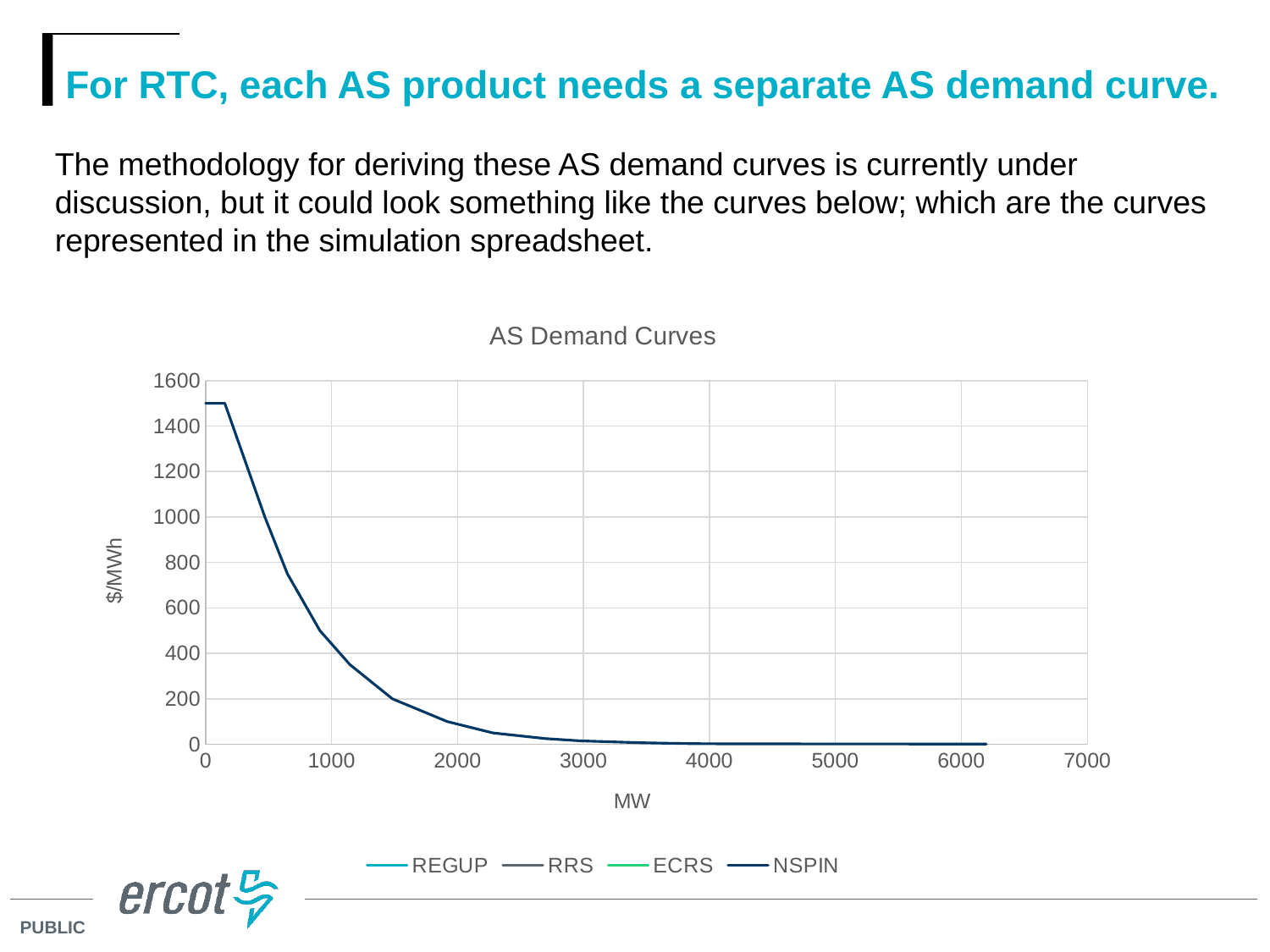
Do the demand curve values rise or fall as MW increases along the x axis? Fall What is the title of the chart? AS Demand Curves Is the value of the demand curve at 1000 MW greater or less than 600 $/MWh? less What kind of chart is shown on the slide? Line chart What is the label of the y axis of the chart? $/MWh Is the demand curve value higher at 1000 MW or at 3000 MW? 1000 MW Is the value of the demand curve at 500 MW greater or less than 800 $/MWh? greater Is the value of the demand curve at 0 MW greater or less than 1400 $/MWh? greater How many series does the chart's legend list? 4